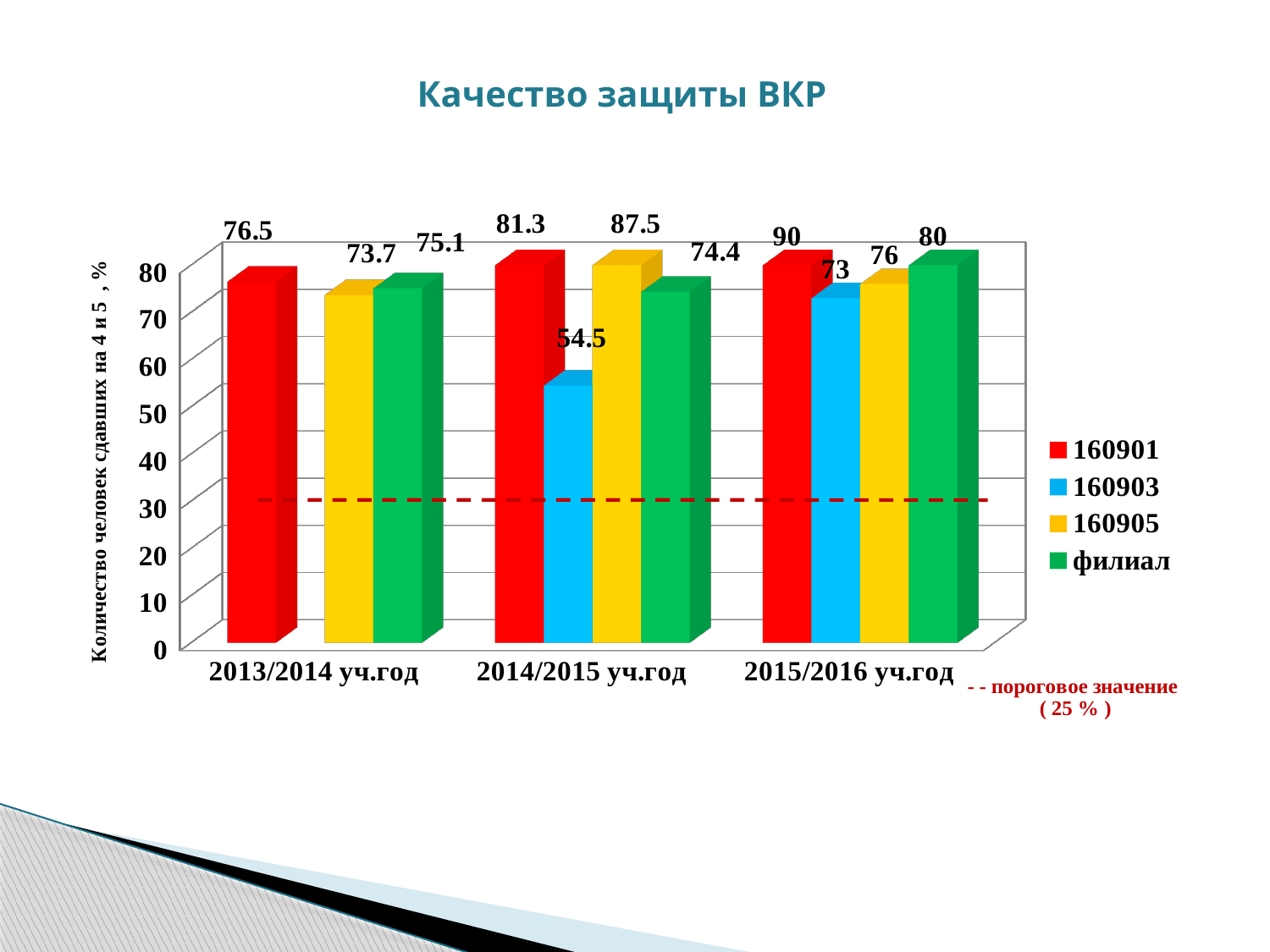
Which series has the highest value in 2015/2016 уч.год? 160901 What kind of chart is shown on the slide? Bar chart Which is larger in 2014/2015 уч.год: the value for 160901 or the value for 160905? 160905 What is the value for 160903 in 2014/2015 уч.год? 54.5 Which series has the lowest value in 2014/2015 уч.год? 160903 What is the value for 160901 in 2013/2014 уч.год? 76.5 How many series does the legend list? 4 What is the value for филиал in 2015/2016 уч.год? 80 What is the value for 160905 in 2014/2015 уч.год? 87.5 What is the difference between the 160901 and 160903 values in 2015/2016 уч.год? 17 Do the values for 160901 rise or fall from 2013/2014 уч.год to 2015/2016 уч.год? Rise How many academic-year categories are shown on the x axis? 3